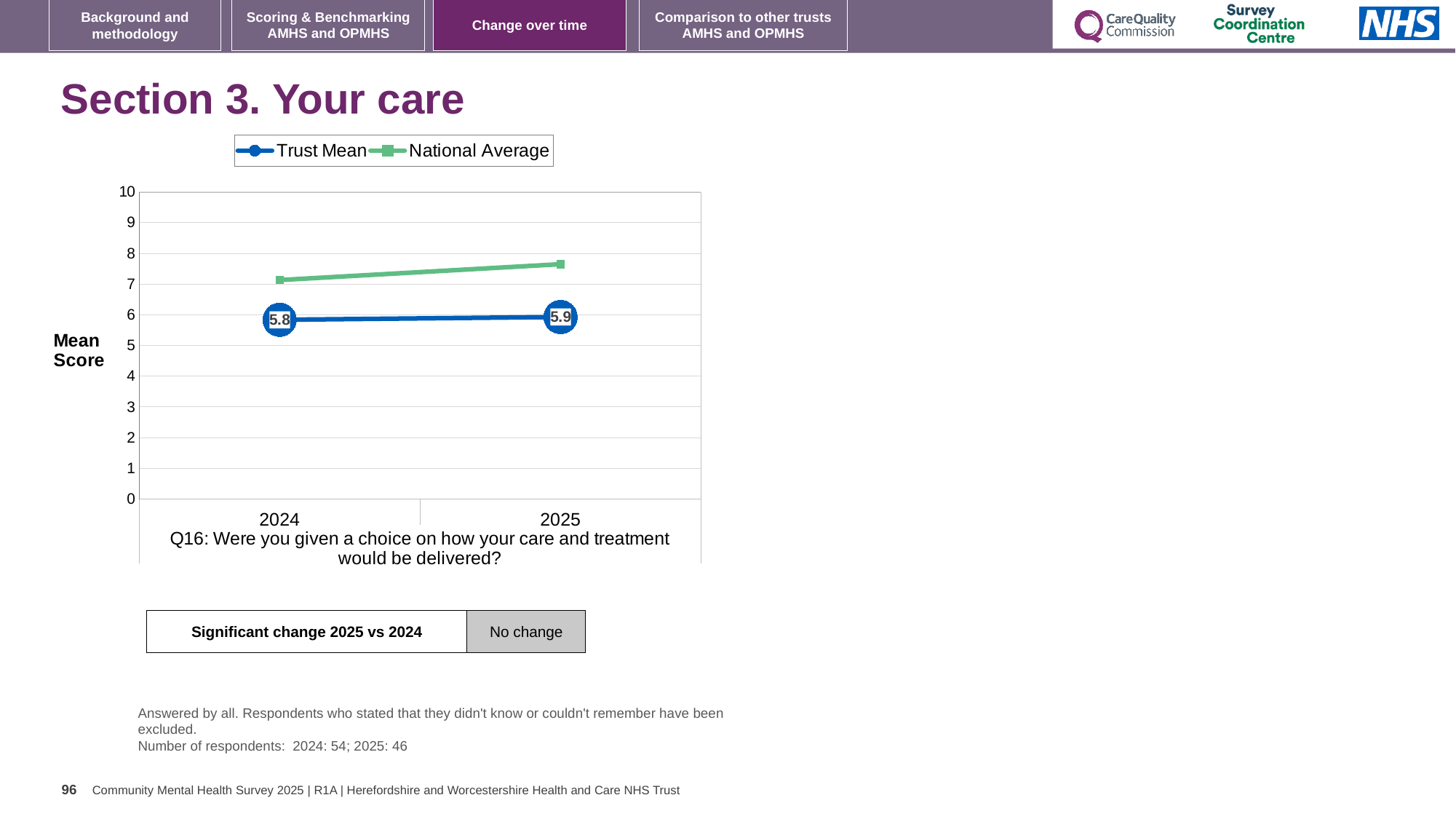
What is the Trust Mean score for 2024? 5.8 What kind of chart is shown on the slide? line chart How many series does the legend list? 2 Which year has the higher Trust Mean score, 2024 or 2025? 2025 Is the National Average value for 2025 greater or less than 7? greater What is the Trust Mean score for 2025? 5.9 In 2025, which series is higher, Trust Mean or National Average? National Average Does the Trust Mean rise or fall from 2024 to 2025? rise How many years are plotted on the x axis? 2 Does the National Average rise or fall from 2024 to 2025? rise Is the National Average value for 2024 greater or less than 8? less By how much did the Trust Mean change from 2024 to 2025? 0.1